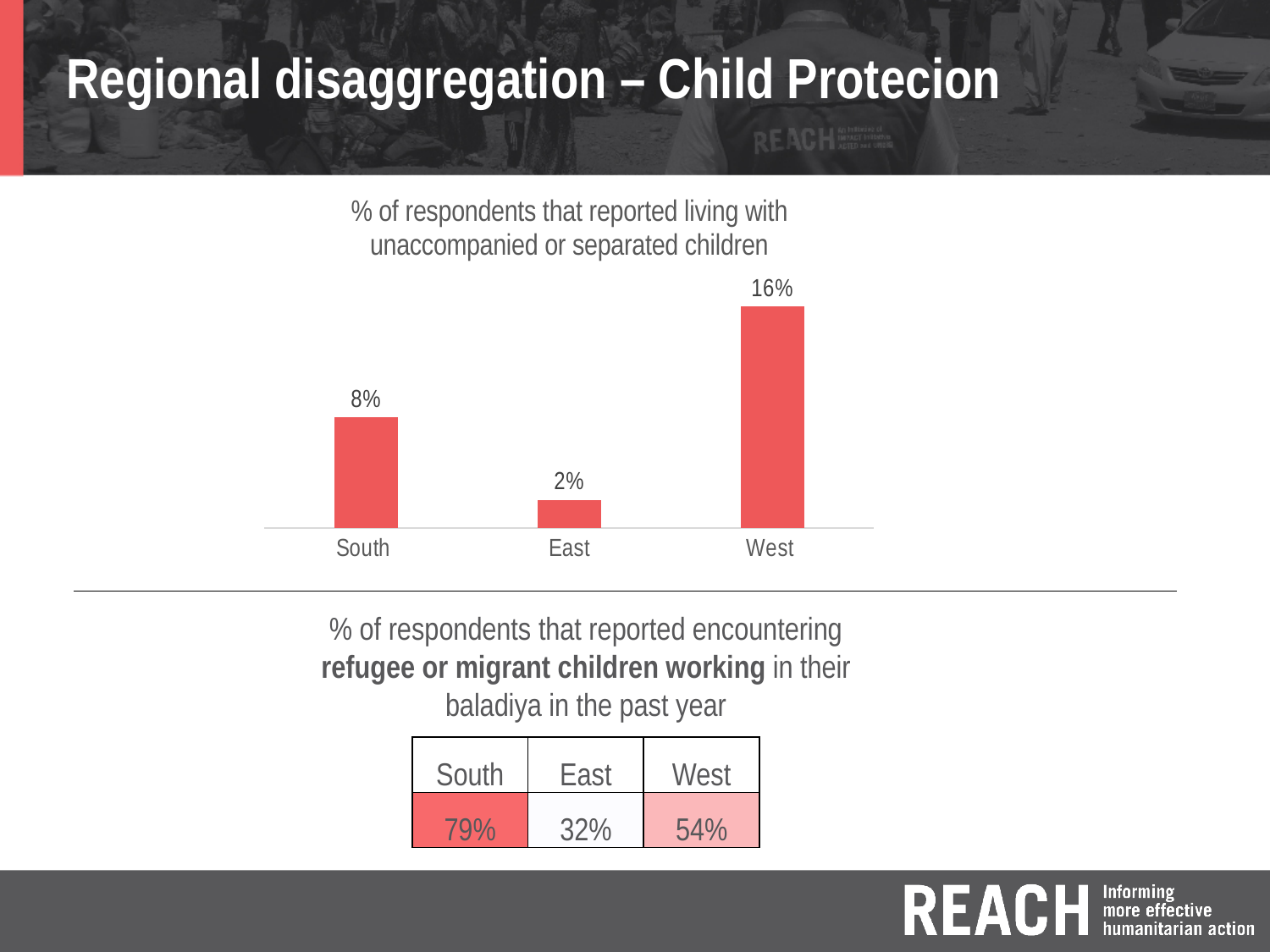
What percentage of respondents in the South reported living with unaccompanied or separated children? 8% What is the difference in percentage points between the South and the East in the chart? 6 What percentage of respondents in the West reported living with unaccompanied or separated children? 16% How many regions are shown in the bar chart? 3 What colour are the bars in the chart? Red What is the difference in percentage points between the West and the South in the chart? 8 What is the title of the bar chart on the slide? % of respondents that reported living with unaccompanied or separated children Which region has a larger value in the chart, South or East? South What type of chart is used to show the percentage of respondents living with unaccompanied or separated children? Bar chart What percentage of respondents in the East reported living with unaccompanied or separated children? 2% Which region has the lowest percentage of respondents reporting living with unaccompanied or separated children? East Which region has the highest percentage of respondents reporting living with unaccompanied or separated children? West